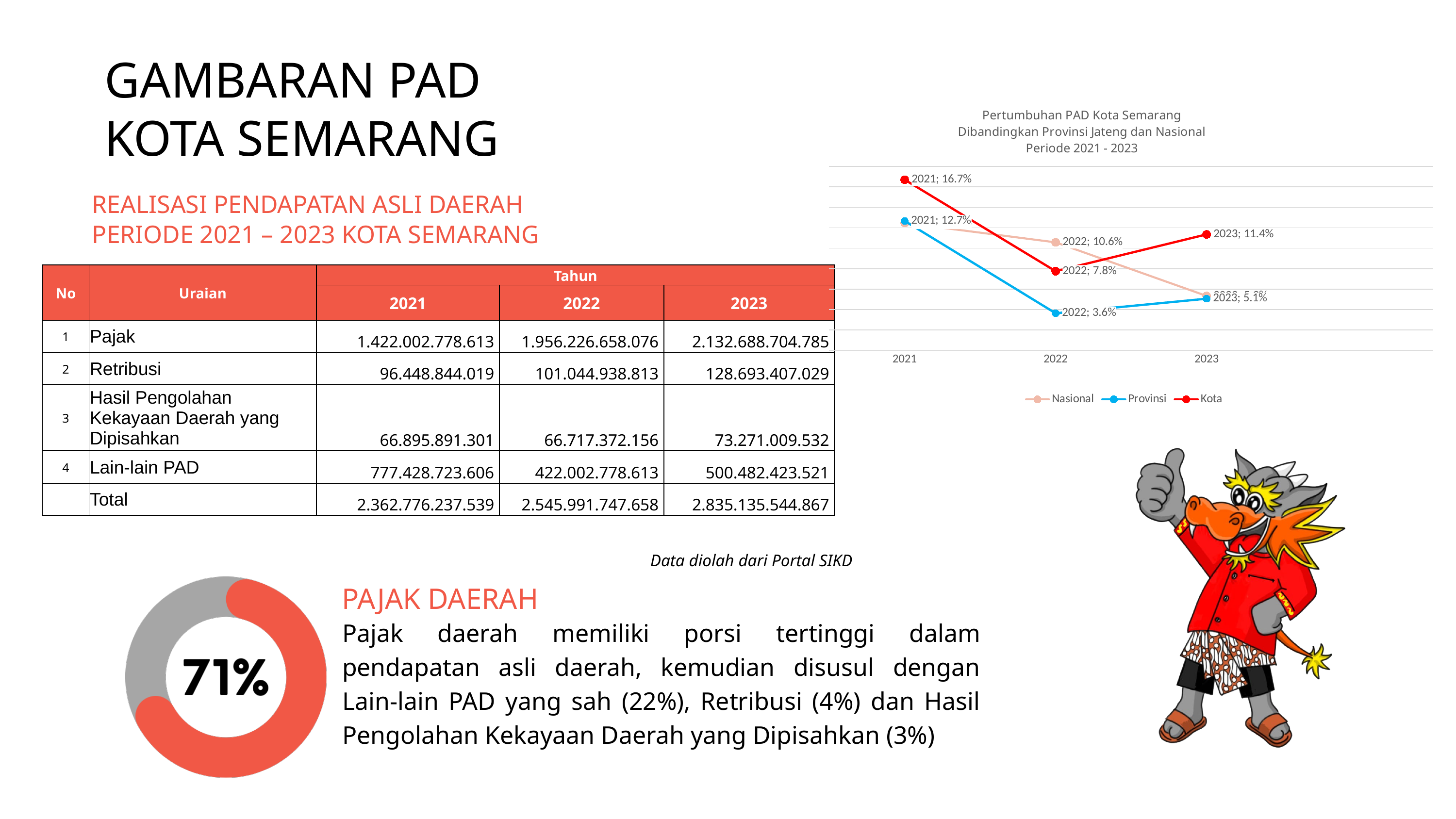
In the 'Pertumbuhan PAD Kota Semarang' chart, what is the difference between the Kota values for 2021 and 2022? 8.9% In the 'Pertumbuhan PAD Kota Semarang' chart, in which year is the Kota series lowest? 2022 In the 'Pertumbuhan PAD Kota Semarang' chart, how many years are shown on the x axis? 3 What type of chart is the 'Pertumbuhan PAD Kota Semarang' chart? line chart In the 'Pertumbuhan PAD Kota Semarang' chart, what is the Kota value for 2023? 11.4% In the 'Pertumbuhan PAD Kota Semarang' chart, what is the Kota value for 2021? 16.7% In the 'Pertumbuhan PAD Kota Semarang' chart, what is the Provinsi value for 2022? 3.6% In the 'Pertumbuhan PAD Kota Semarang' chart, what is the Nasional value for 2022? 10.6% In the 'Pertumbuhan PAD Kota Semarang' chart, what is the Kota value for 2022? 7.8% In the 'Pertumbuhan PAD Kota Semarang' chart, how many series does the legend list? 3 In the 'Pertumbuhan PAD Kota Semarang' chart, which series has the higher value in 2022, Kota or Provinsi? Kota In the 'Pertumbuhan PAD Kota Semarang' chart, in which year is the Kota series highest? 2021